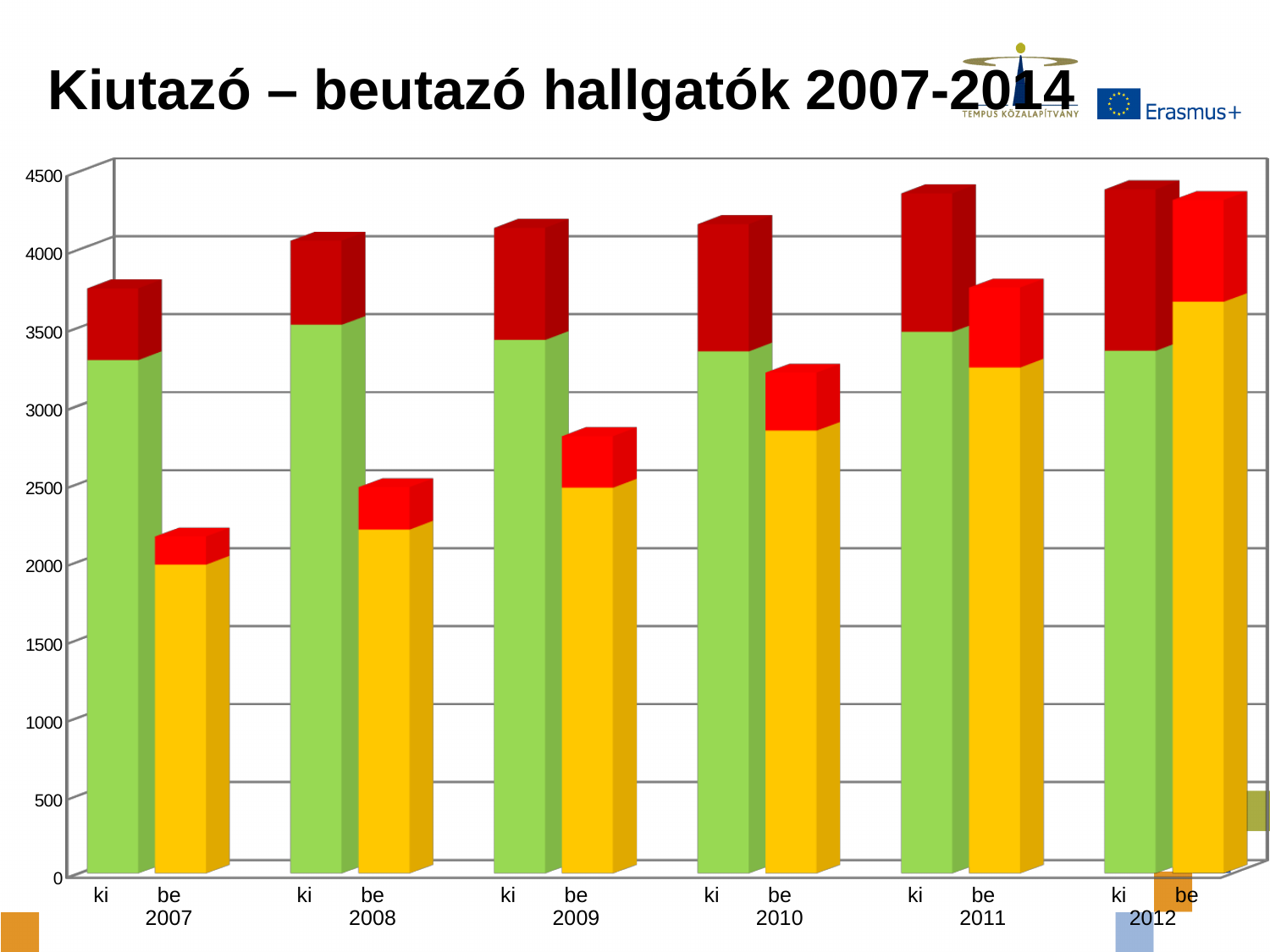
What is the title of the slide? Kiutazó – beutazó hallgatók 2007-2014 How many years are shown along the x axis of the chart? 6 Which year has the shortest 'be' bar? 2007 Do the 'be' bars rise or fall from 2007 to 2012? rise What kind of chart is shown on the slide? bar chart Is the value of the 'ki' bar for 2012 greater or less than 4000? greater Is the value of the 'be' bar for 2009 greater or less than 3000? less Is the value of the 'ki' bar for 2007 greater or less than 3000? greater Which year has the tallest 'be' bar? 2012 In 2007, which bar is taller, 'ki' or 'be'? ki How many bars are plotted in the chart in total? 12